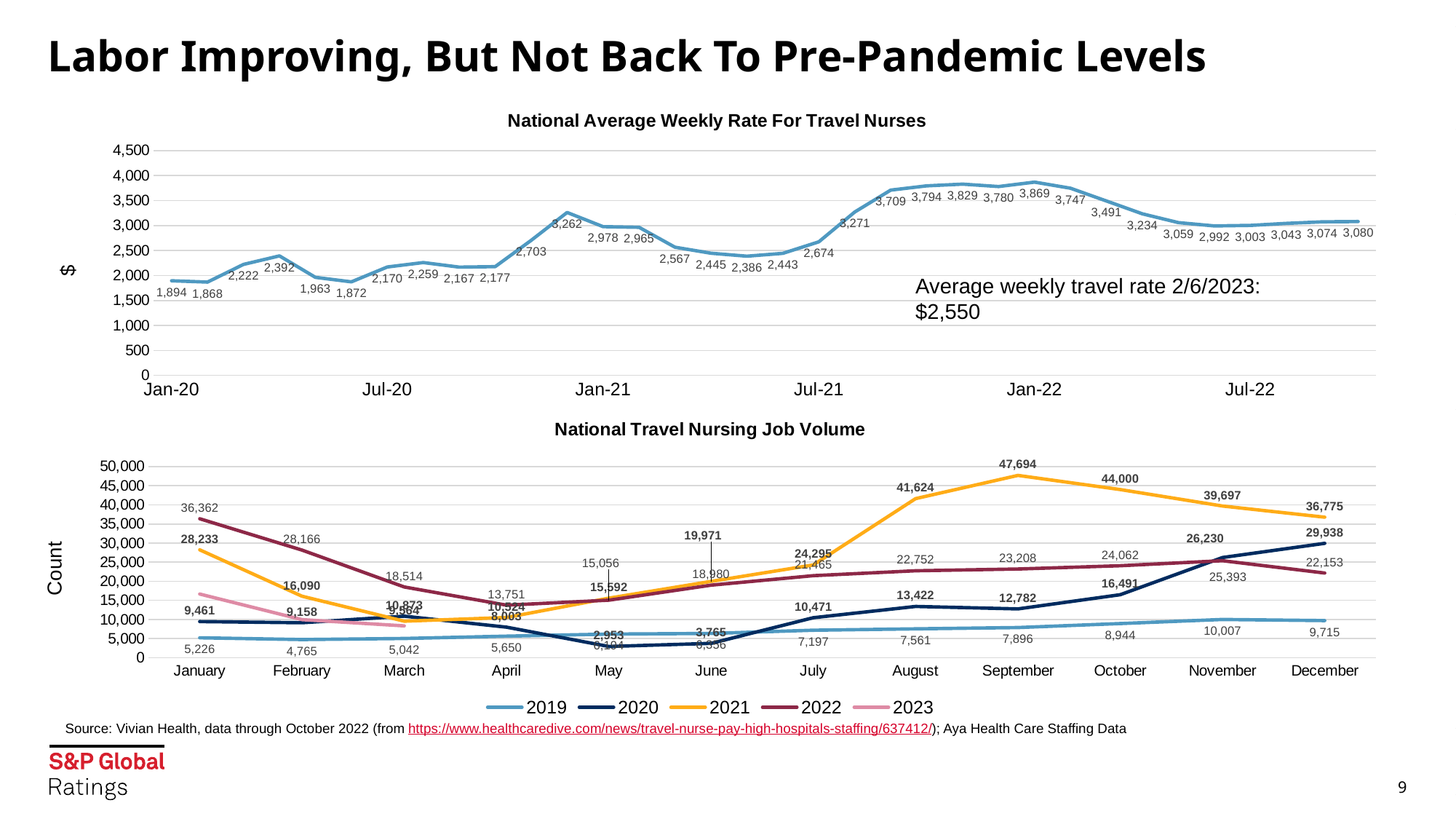
How many months are shown on the x axis of the 'National Travel Nursing Job Volume' chart? 12 In the 'National Travel Nursing Job Volume' chart, is the 2023 value for January greater or less than 10,000? greater In the 'National Travel Nursing Job Volume' chart, which series has the larger value in December, 2021 or 2022? 2021 How many series does the legend of the 'National Travel Nursing Job Volume' chart list? 5 What type of chart is the 'National Average Weekly Rate For Travel Nurses' chart? Line chart In the 'National Average Weekly Rate For Travel Nurses' chart, what is the value at Jan-20? 1,894 In the 'National Travel Nursing Job Volume' chart, what is the 2021 value for September? 47,694 In the 'National Travel Nursing Job Volume' chart, what is the difference between the 2021 values for September and October? 3,694 In the 'National Travel Nursing Job Volume' chart, what is the 2022 value for January? 36,362 In the 'National Average Weekly Rate For Travel Nurses' chart, what is the lowest value plotted? 1,868 According to the annotation on the 'National Average Weekly Rate For Travel Nurses' chart, what was the average weekly travel rate on 2/6/2023? $2,550 In the 'National Average Weekly Rate For Travel Nurses' chart, what is the highest value plotted? 3,869